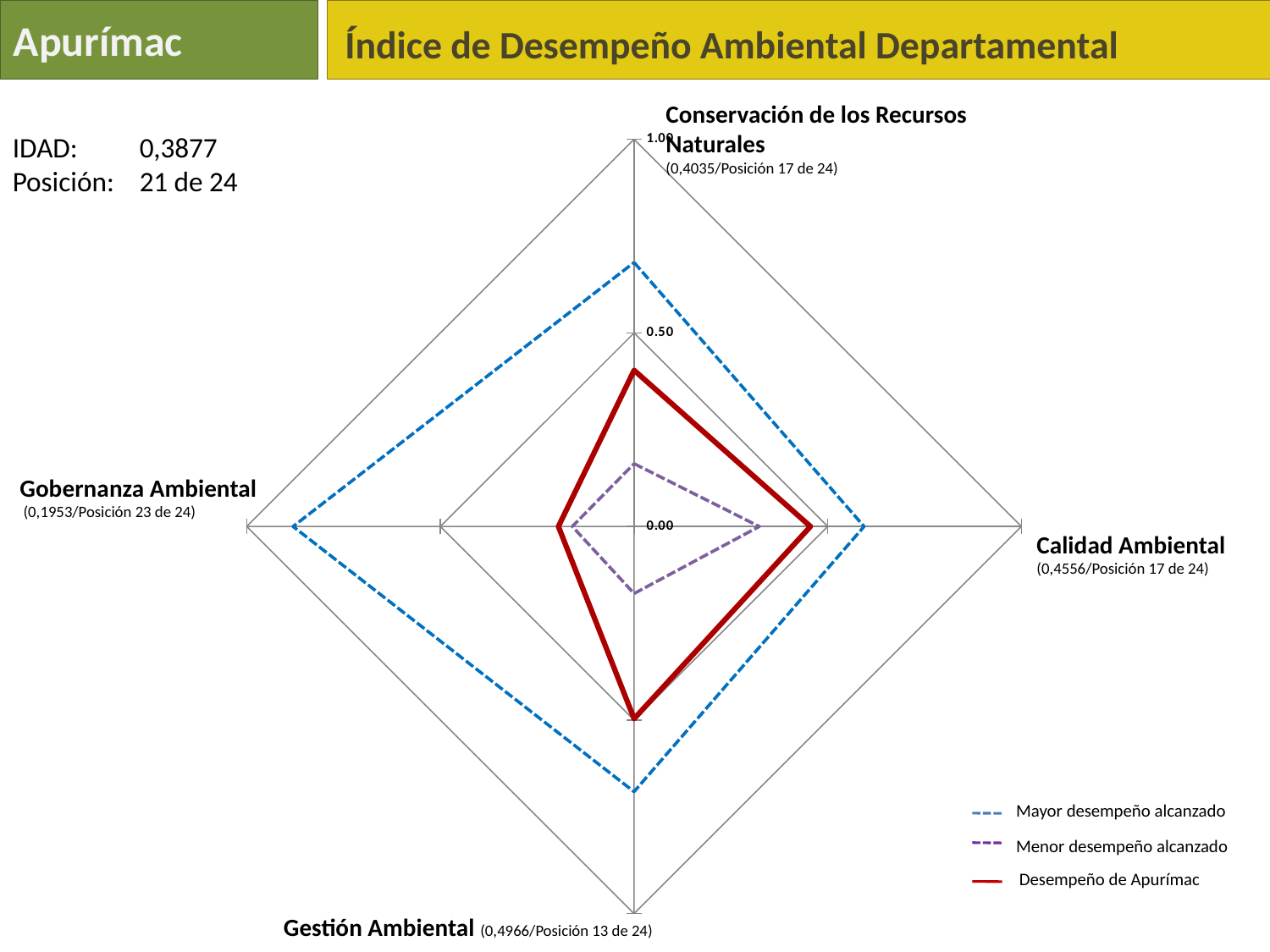
Which legend entry is drawn as a solid red line? Desempeño de Apurímac Which is larger for Apurímac: Calidad Ambiental or Conservación de los Recursos Naturales? Calidad Ambiental In which category does Apurímac have its highest value? Gestión Ambiental Is the 'Mayor desempeño alcanzado' value for Gestión Ambiental greater or less than 0.50? greater What is Apurímac's value for Gobernanza Ambiental? 0,1953 In which category does Apurímac have its lowest value? Gobernanza Ambiental What is Apurímac's value for Calidad Ambiental? 0,4556 What is the difference between Apurímac's values for Gestión Ambiental and Gobernanza Ambiental? 0,3013 What type of chart is shown on the slide? Radar chart How many axes (categories) does the radar chart have? 4 How many series does the legend list? 3 What is Apurímac's value for Gestión Ambiental? 0,4966